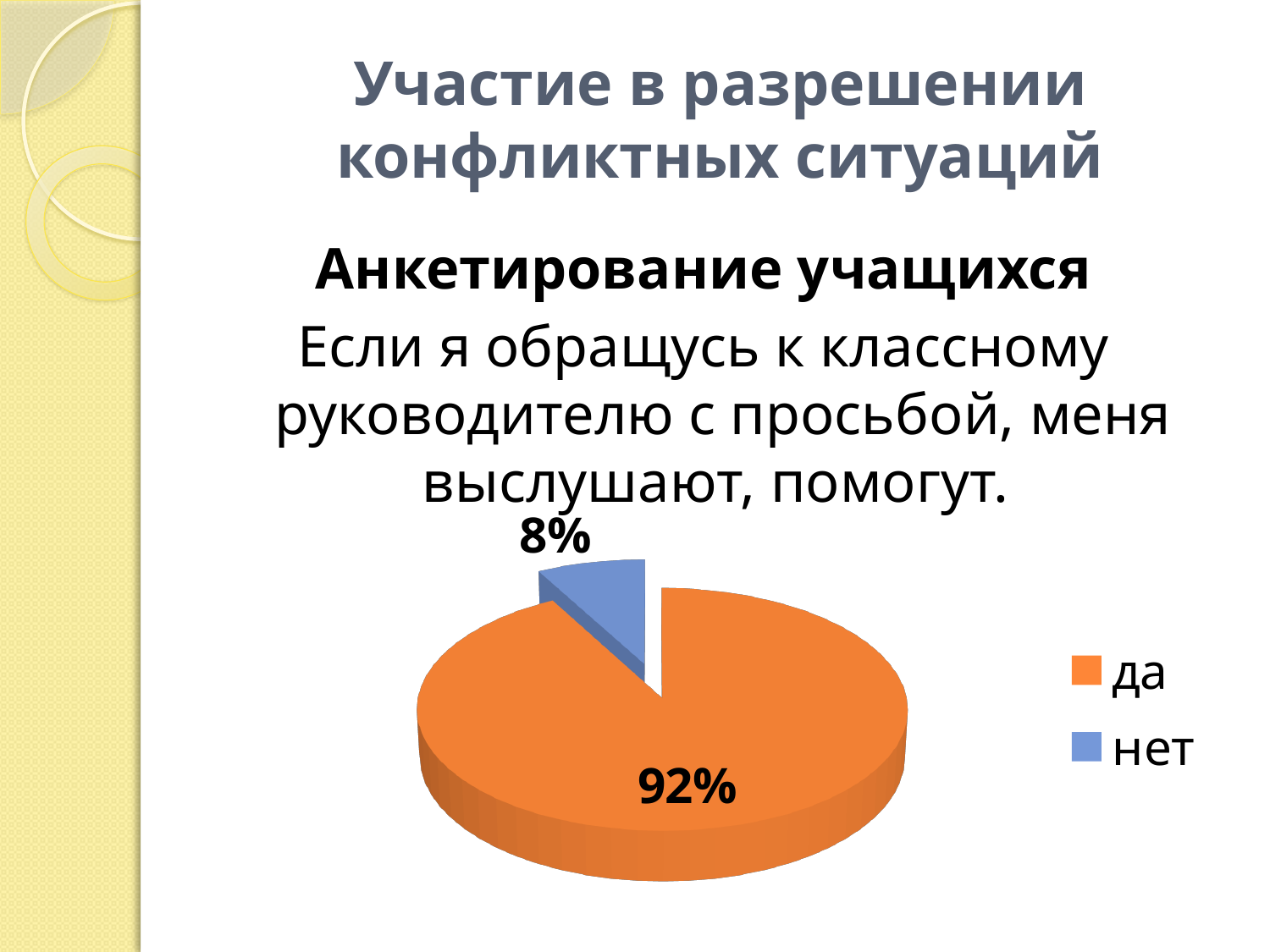
Which answer has the largest share of the pie? да What colour is the slice for "нет"? blue Which is larger, the share for "да" or the share for "нет"? да How many slices does the pie chart have? 2 What percentage of students answered "да"? 92% Which answer has the smallest share of the pie? нет What colour is the slice for "да"? orange What percentage of students answered "нет"? 8% What is the difference between the share for "да" and the share for "нет"? 84% What kind of chart is shown on the slide? pie chart How many entries does the legend list? 2